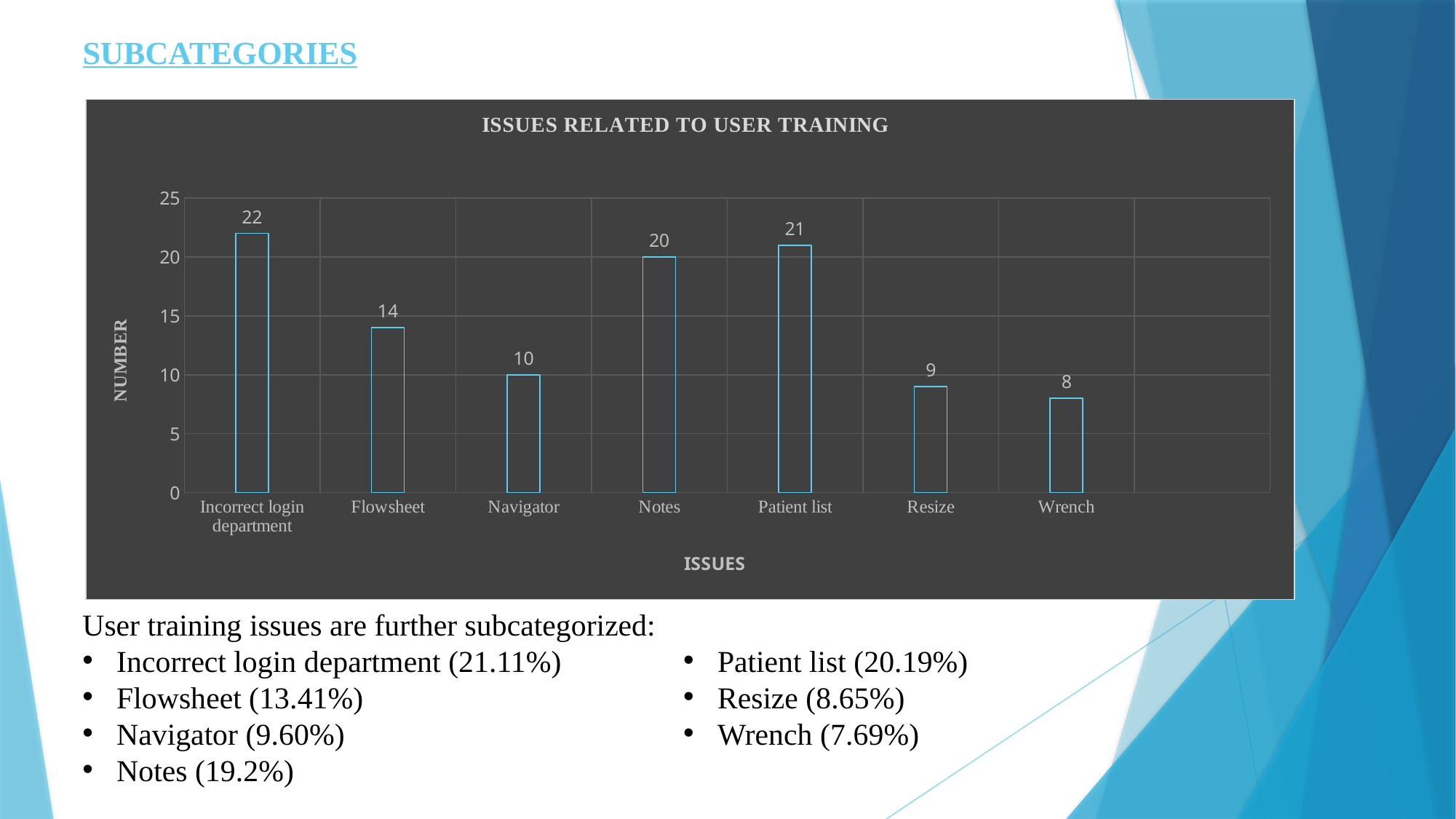
What is the value for Notes? 20 What is the difference between the values for Incorrect login department and Flowsheet? 8 Is the value for Patient list greater or less than 15? greater What kind of chart is this? bar chart Which is larger, the value for Flowsheet or the value for Navigator? Flowsheet What is the value for Wrench? 8 What is the value for Incorrect login department? 22 Which category has the lowest value? Wrench What is the difference between the values for Patient list and Resize? 12 How many categories are shown on the x axis? 7 What is the title of the chart? ISSUES RELATED TO USER TRAINING Which category has the highest value? Incorrect login department